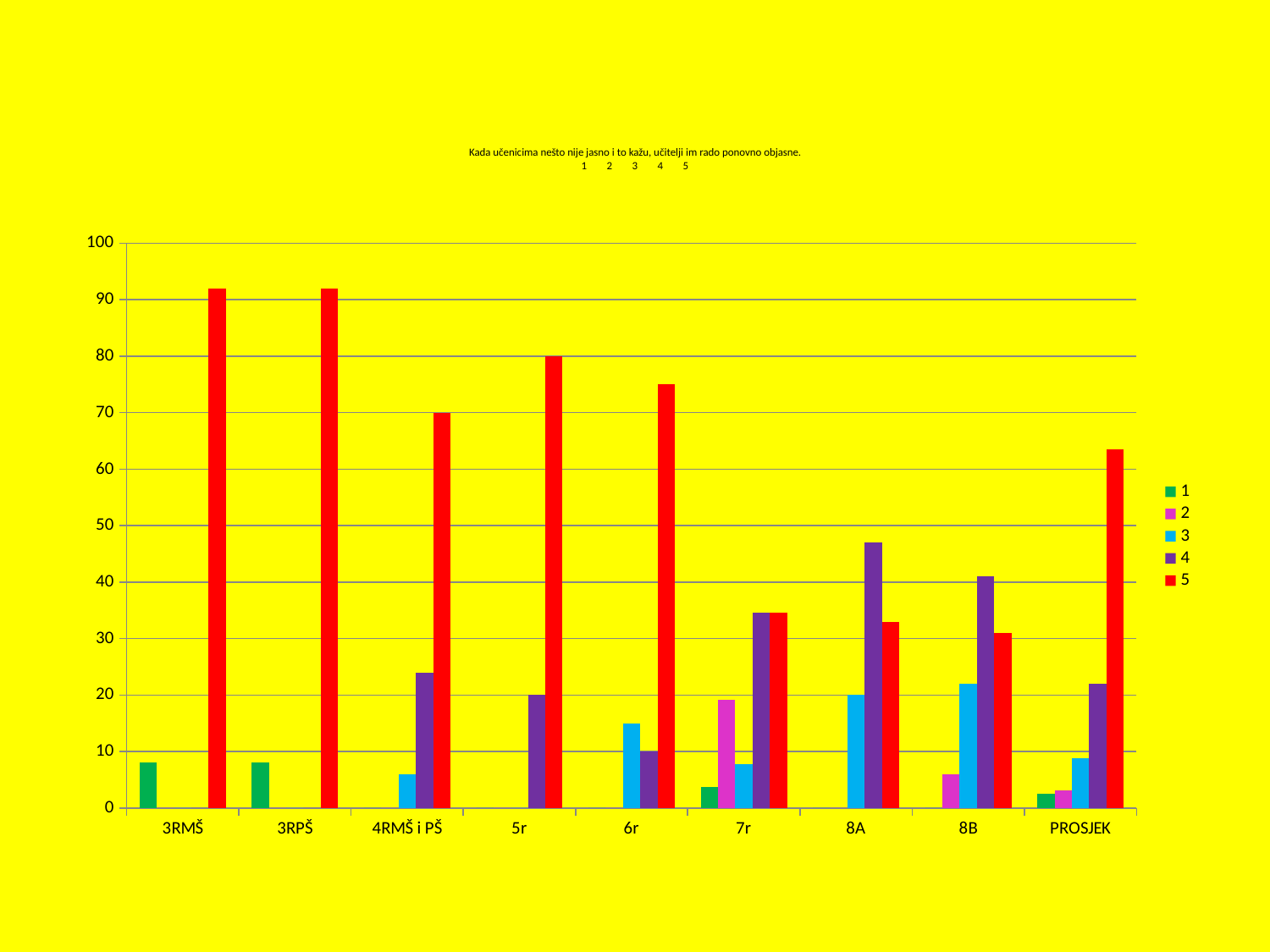
What is the value of series 5 for 5r? 80 How many categories are shown along the x axis? 9 What is the value of series 5 for 4RMŠ i PŠ? 70 Is the value of series 5 for 3RMŠ greater or less than 90? greater Is the value of series 5 for PROSJEK greater or less than 60? greater How many series does the legend list? 5 What colour represents series 5 in the legend? red What kind of chart is shown on the slide? bar chart Which is larger: the value of series 4 for 8A or the value of series 4 for 8B? 8A Which series has the highest value for 8B? 4 Which series has the highest value for 8A? 4